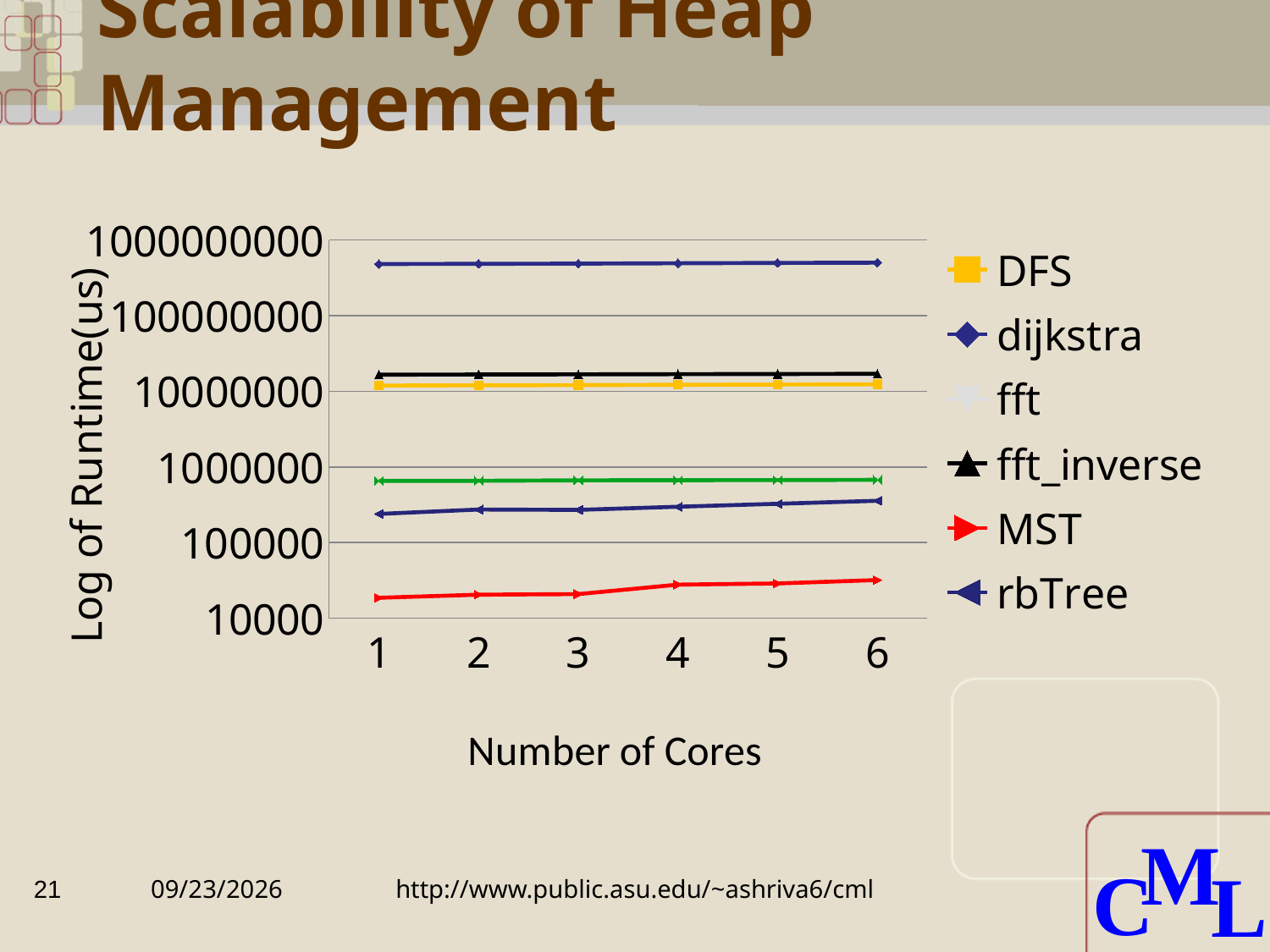
Which series has the highest runtime across all core counts? dijkstra Which series has the lowest runtime across all core counts? MST What is the title of the x axis? Number of Cores How many series does the legend list? 6 Is the runtime for rbTree at 1 core greater or less than 100000? greater How many values of Number of Cores are plotted along the x axis? 6 Does the runtime for MST rise or fall as the number of cores increases from 1 to 6? rise What kind of chart is shown on the slide? line chart Is the runtime for dijkstra at 1 core greater or less than 100000000? greater Is the runtime for fft_inverse at 6 cores greater or less than 10000000? greater Which series has the larger runtime at 6 cores, dijkstra or rbTree? dijkstra